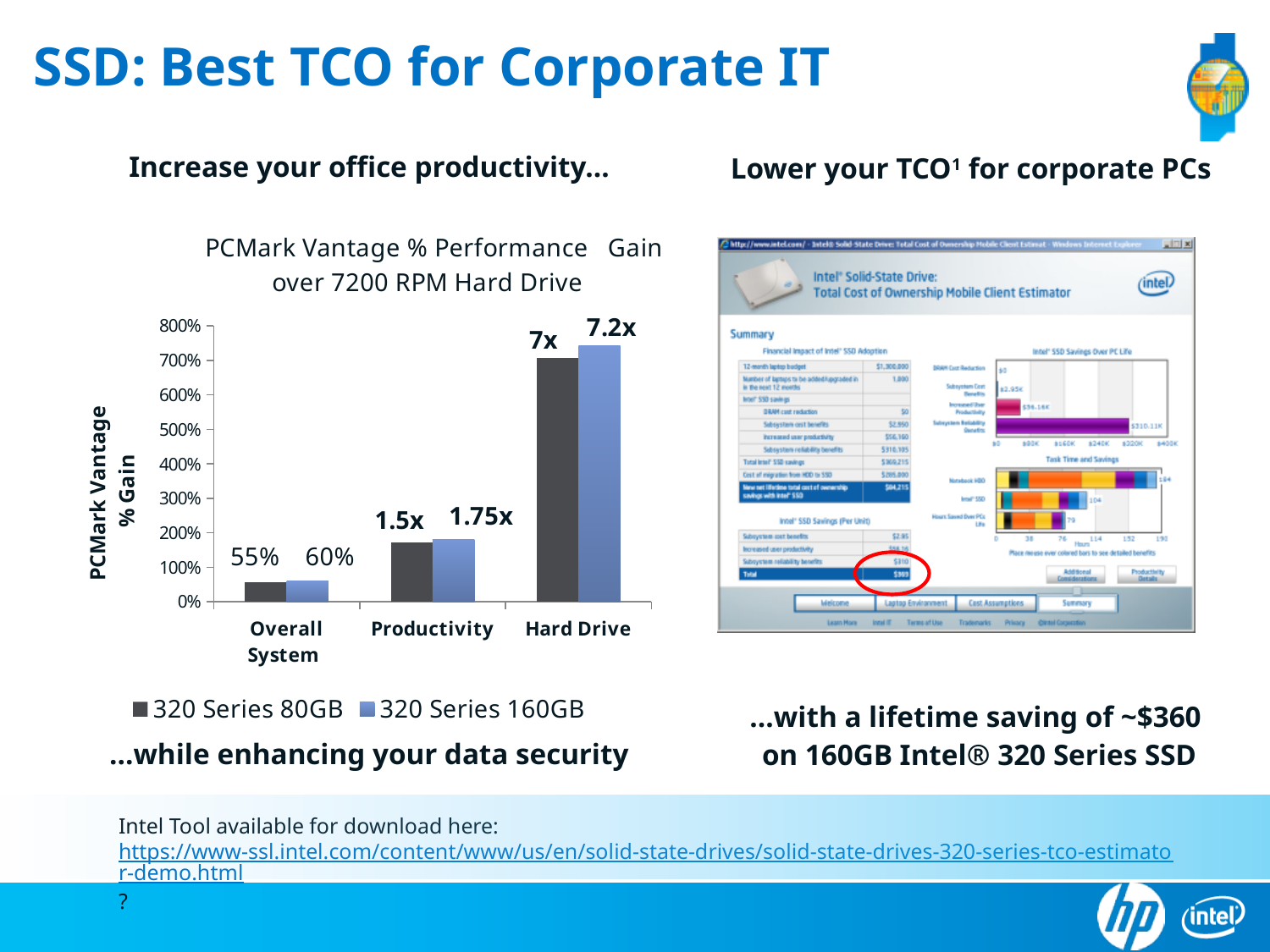
In the PCMark Vantage chart, do the values rise or fall from Overall System to Hard Drive? rise In the PCMark Vantage chart, is the value for 320 Series 160GB in the Hard Drive category greater or less than 700%? greater In the PCMark Vantage chart, what is the value for 320 Series 80GB in the Overall System category? 55% In the PCMark Vantage chart, which series has the larger value in the Productivity category? 320 Series 160GB What kind of chart is the PCMark Vantage chart? bar chart How many series does the legend of the PCMark Vantage chart list? 2 In the PCMark Vantage chart, which category shows the highest performance gain? Hard Drive In the PCMark Vantage chart, what is the value for 320 Series 160GB in the Productivity category? 1.75x In the PCMark Vantage chart, which category shows the lowest performance gain? Overall System How many categories are shown on the x axis of the PCMark Vantage chart? 3 In the PCMark Vantage chart, what is the value for 320 Series 80GB in the Hard Drive category? 7x In the PCMark Vantage chart, what is the value for 320 Series 160GB in the Overall System category? 60%